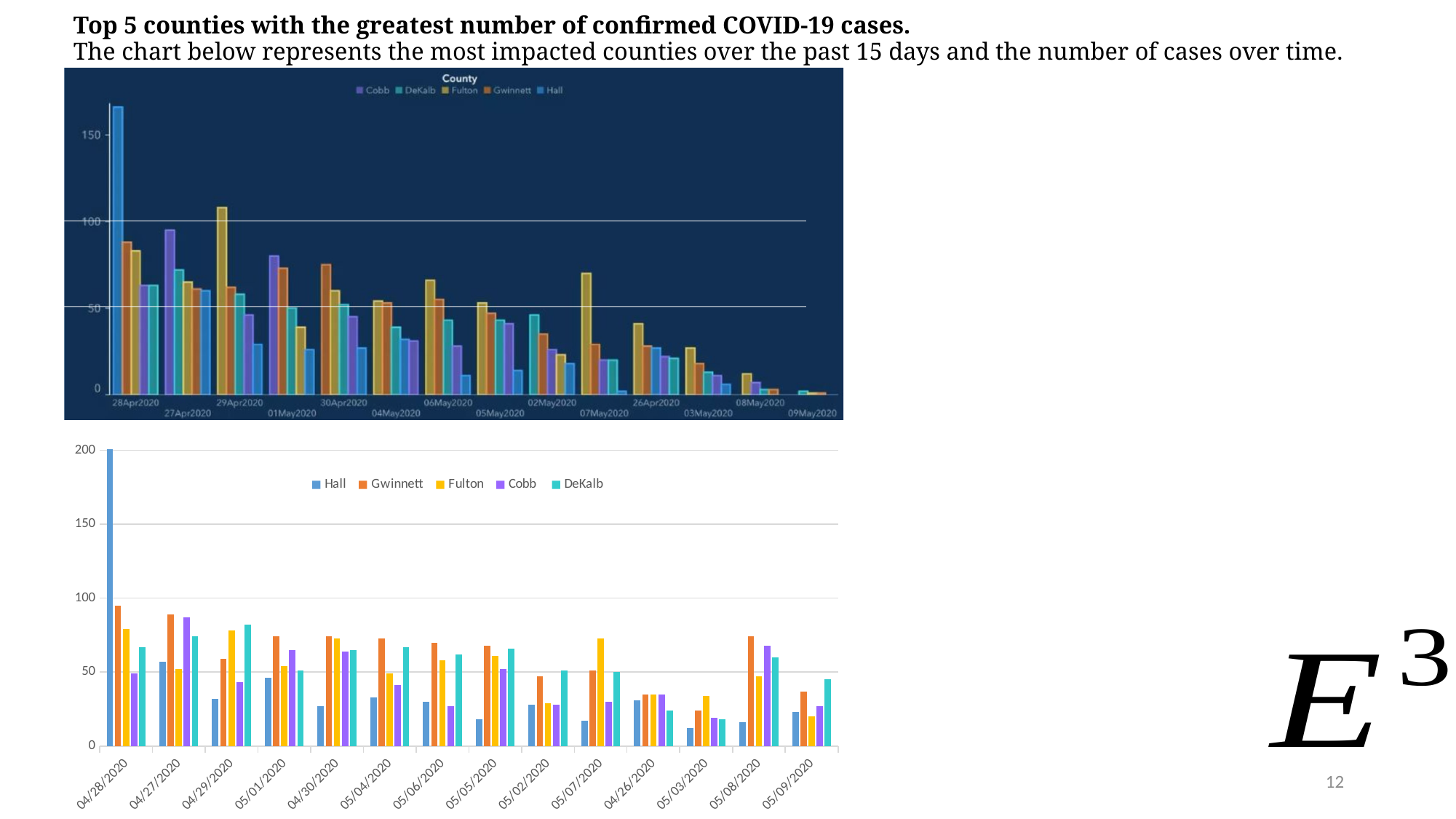
In the bottom chart, is the value for Gwinnett on 04/28/2020 greater or less than 100? less Which series is listed first in the legend of the bottom chart? Hall In the top chart, is the value for Fulton on 29Apr2020 greater or less than 100? greater In the bottom chart, which county has the tallest bar on 04/29/2020? DeKalb How many series does the legend of the top chart list? 5 What type of chart is the top chart on the slide? bar chart In the bottom chart, is the value for Hall on 05/03/2020 greater or less than 50? less In the top chart, which county has the tallest bar on 28Apr2020? Hall How many date categories are shown on the x axis of the bottom chart? 14 In the bottom chart, on 04/28/2020, which is larger: the value for Hall or the value for Gwinnett? Hall